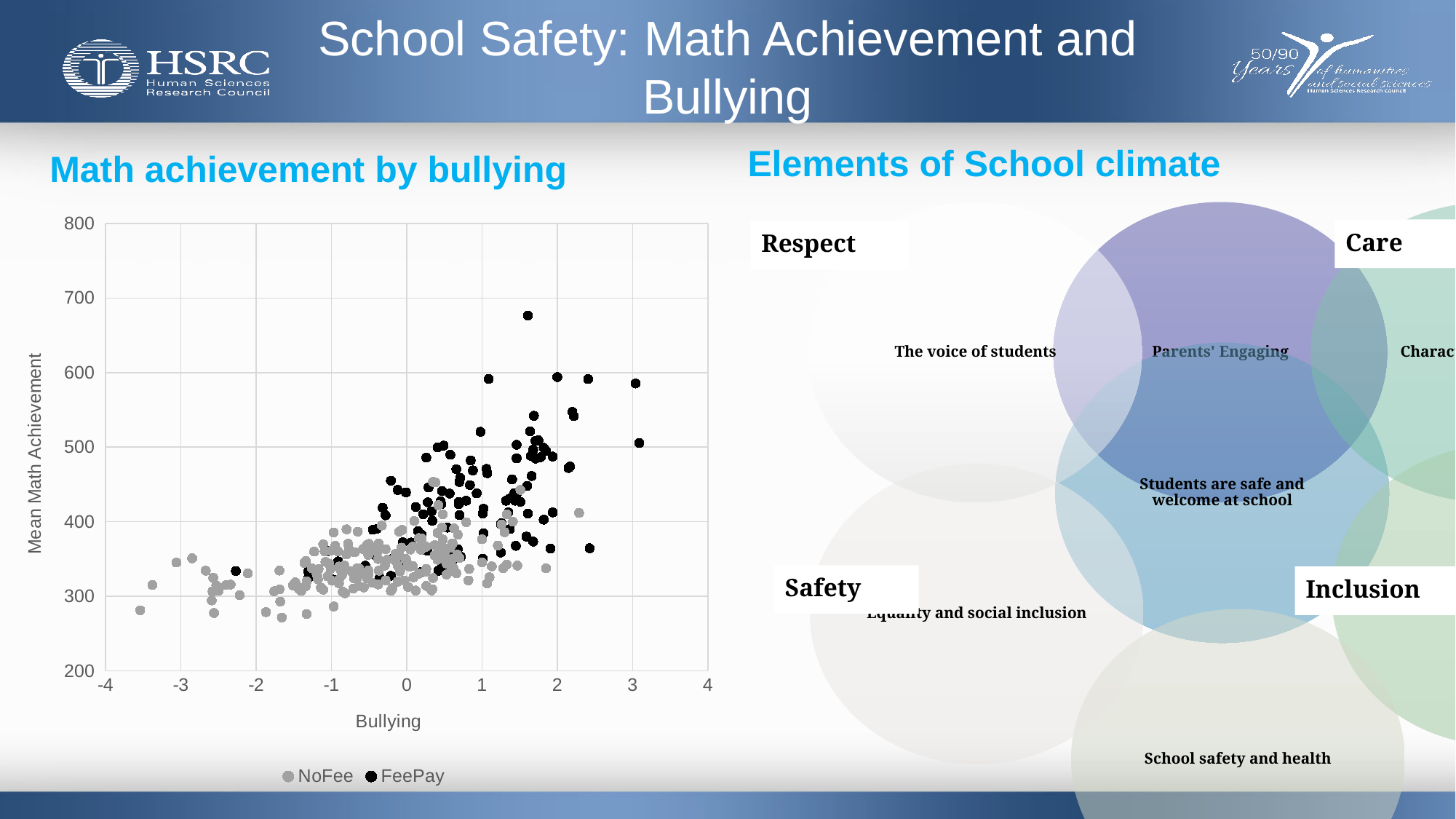
What are the two series named in the legend of the 'Math achievement by bullying' chart? NoFee and FeePay How many series does the legend of the 'Math achievement by bullying' chart list? 2 In the 'Math achievement by bullying' chart, which series contains the point with the lowest mean math achievement? NoFee What kind of chart is 'Math achievement by bullying'? scatter chart In the 'Math achievement by bullying' chart, is the highest plotted mean math achievement value greater or less than 600? greater In the 'Math achievement by bullying' chart, does mean math achievement generally rise or fall as bullying increases along the x axis? rise In the 'Math achievement by bullying' chart, which series contains the point with the highest mean math achievement? FeePay In the 'Math achievement by bullying' chart, is the highest plotted mean math achievement value greater or less than 700? less In the 'Math achievement by bullying' chart, is the lowest plotted mean math achievement value greater or less than 300? less In the 'Math achievement by bullying' chart, which series has points with the lowest bullying values (furthest left on the x axis)? NoFee In the 'Math achievement by bullying' chart, which series generally has higher mean math achievement values, NoFee or FeePay? FeePay What is the title of the horizontal axis of the 'Math achievement by bullying' chart? Bullying